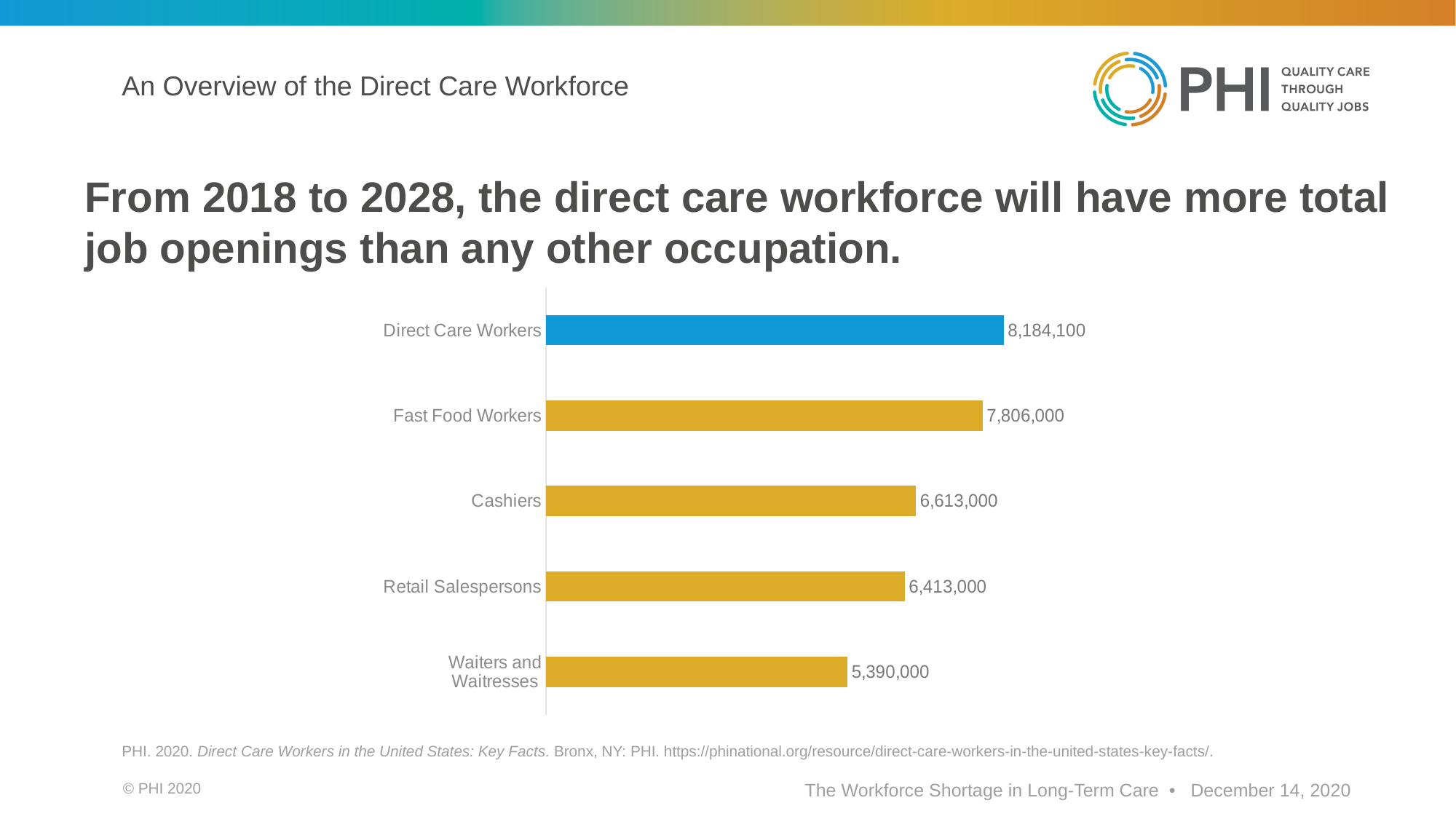
What is the difference between the values for Cashiers and Retail Salespersons? 200,000 Which category has the lowest value? Waiters and Waitresses How many categories are shown in the chart? 5 Which bar is coloured differently from the others? Direct Care Workers What is the value for Cashiers? 6,613,000 What is the value for Waiters and Waitresses? 5,390,000 What kind of chart is shown on the slide? Bar chart What is the difference between the values for Direct Care Workers and Fast Food Workers? 378,100 Which is larger, the value for Retail Salespersons or the value for Waiters and Waitresses? Retail Salespersons Which category has the highest value? Direct Care Workers What is the value for Direct Care Workers? 8,184,100 What is the value for Fast Food Workers? 7,806,000